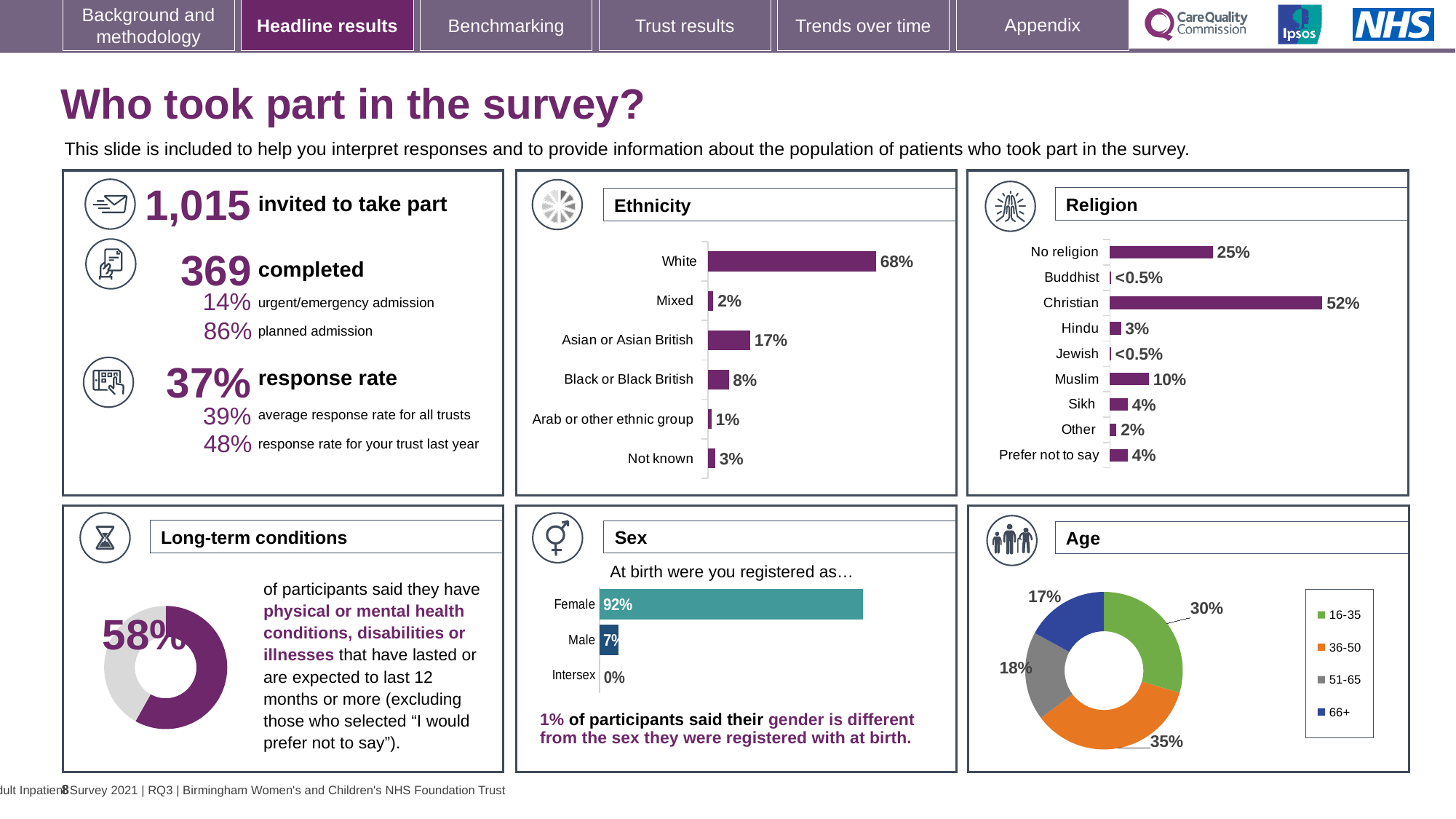
How many categories are shown in the Religion chart? 9 In the Religion chart, which is larger, the value for No religion or the value for Muslim? No religion In the Sex chart, what percentage of participants were registered as Female at birth? 92% In the Ethnicity chart, what is the difference between the values for Asian or Asian British and Black or Black British? 9% In the Religion chart, which religion category has the highest value? Christian In the Sex chart, what is the difference between the Female and Male values? 85% In the Age chart, what share of participants were aged 36-50? 35% In the Ethnicity chart, which category has the lowest value? Arab or other ethnic group How many age groups does the legend of the Age chart list? 4 In the Ethnicity chart, what percentage of participants were White? 68% In the Religion chart, what percentage of participants were Muslim? 10% What kind of chart is the Age chart? Doughnut chart